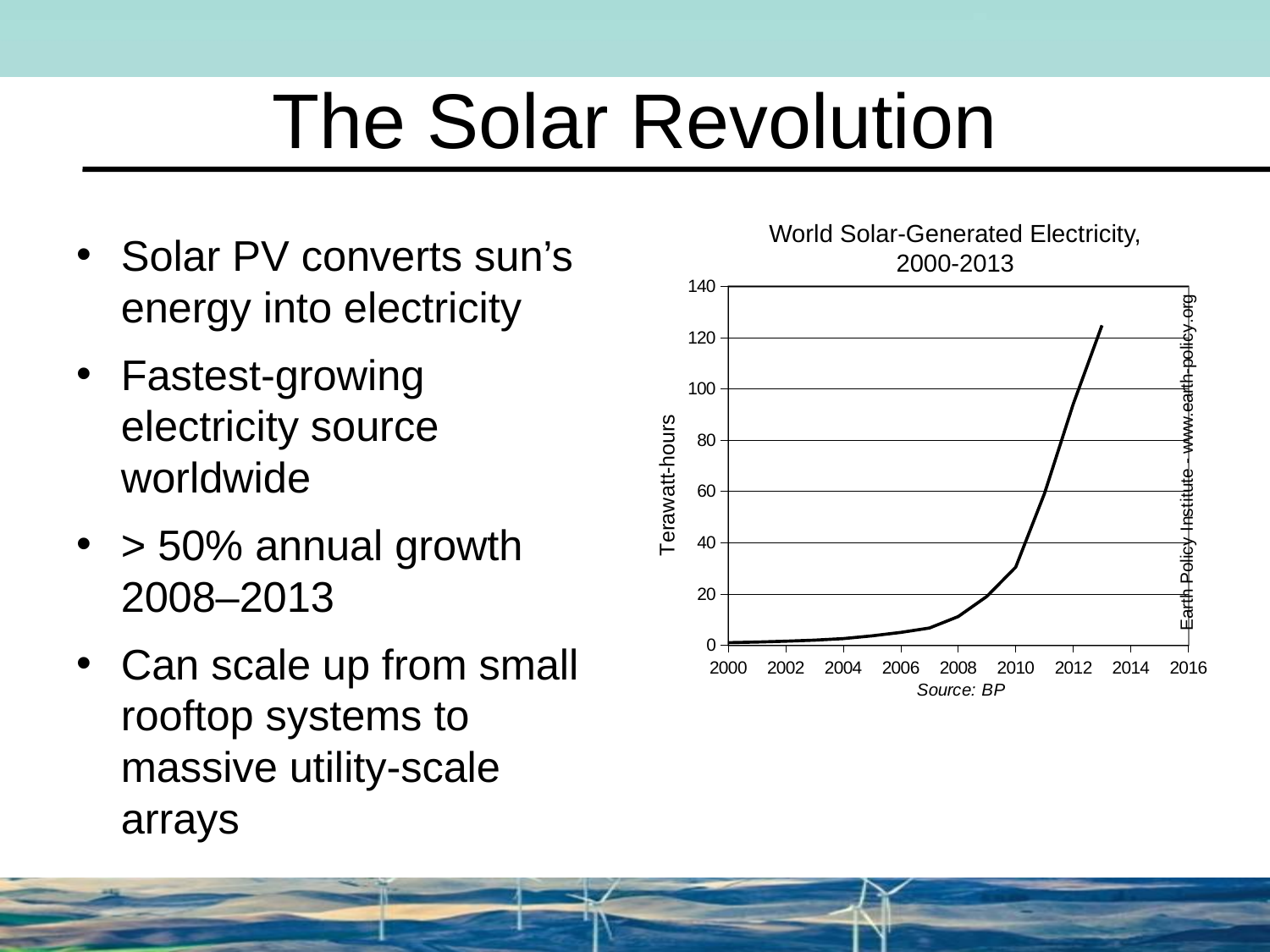
What is the title of the chart? World Solar-Generated Electricity, 2000-2013 Do the values in the chart rise or fall from 2000 to 2013? rise Is the value for 2012 greater or less than 60? greater Is the value for 2008 greater or less than 20? less What unit is shown on the vertical axis of the chart? Terawatt-hours What kind of chart is shown on the slide? line chart Is the value for 2010 greater or less than 40? less Which year has the larger value, 2004 or 2009? 2009 Which year has the larger value, 2010 or 2012? 2012 In which year is the plotted value lowest? 2000 In which year is the plotted value highest? 2013